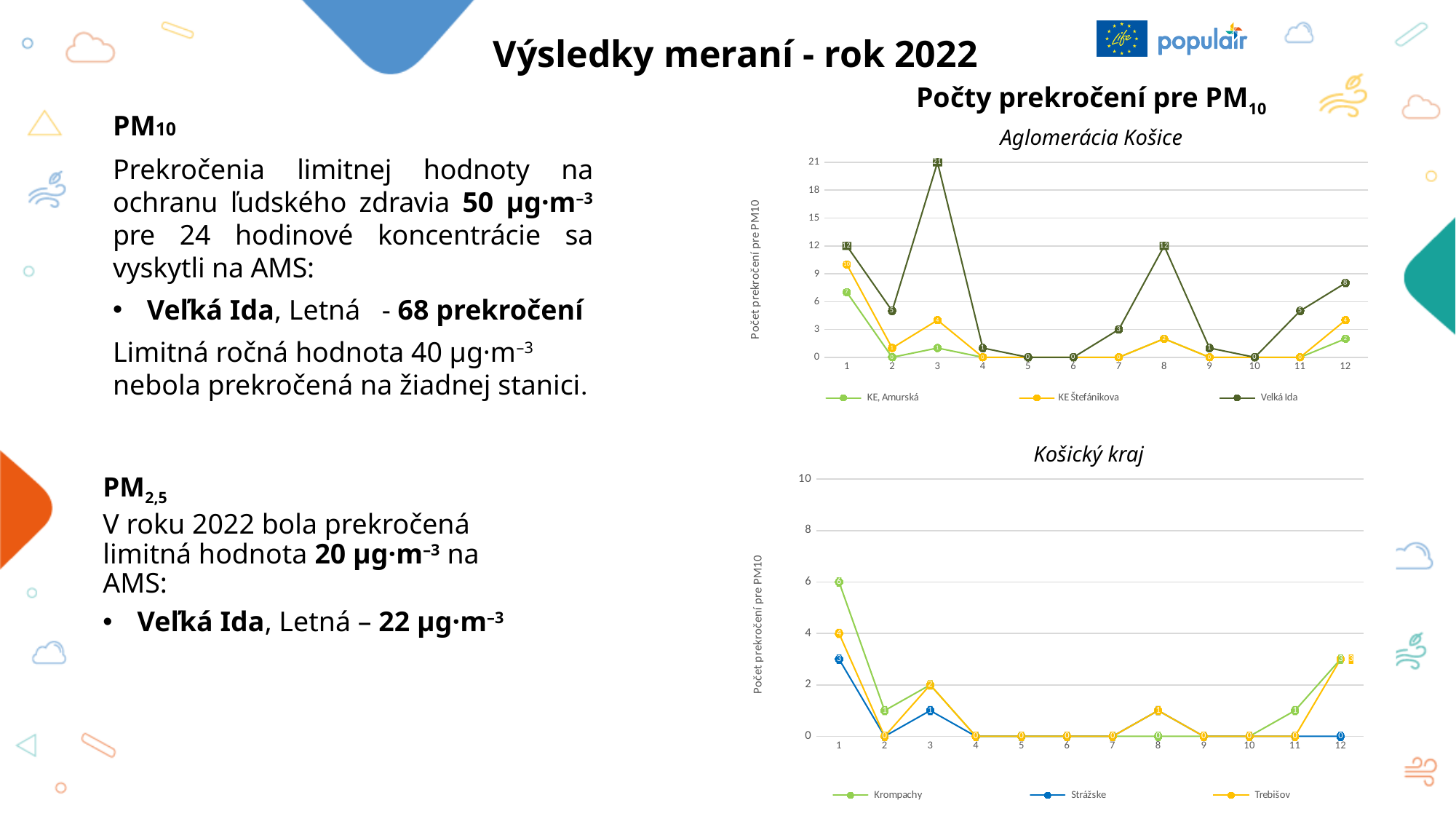
In the Aglomerácia Košice chart, what is the value for KE Štefánikova in month 1? 10 In the Košický kraj chart, what is the value for Krompachy in month 1? 6 What is the y-axis title of the Košický kraj chart? Počet prekročení pre PM10 In the Aglomerácia Košice chart, what is the difference between the Veľká Ida values in month 3 and month 1? 9 How many months are plotted on the x axis of the Košický kraj chart? 12 In the Košický kraj chart, do the Krompachy values rise or fall from month 1 to month 2? fall In the Aglomerácia Košice chart, what is the value for Veľká Ida in month 3? 21 How many series does the legend of the Aglomerácia Košice chart list? 3 In the Aglomerácia Košice chart, is the value for Veľká Ida in month 3 greater or less than 18? greater In the Aglomerácia Košice chart, in which month does Veľká Ida reach its highest value? 3 What kind of chart is the Košický kraj chart? line chart In the Košický kraj chart, which is larger in month 1: Krompachy or Strážske? Krompachy